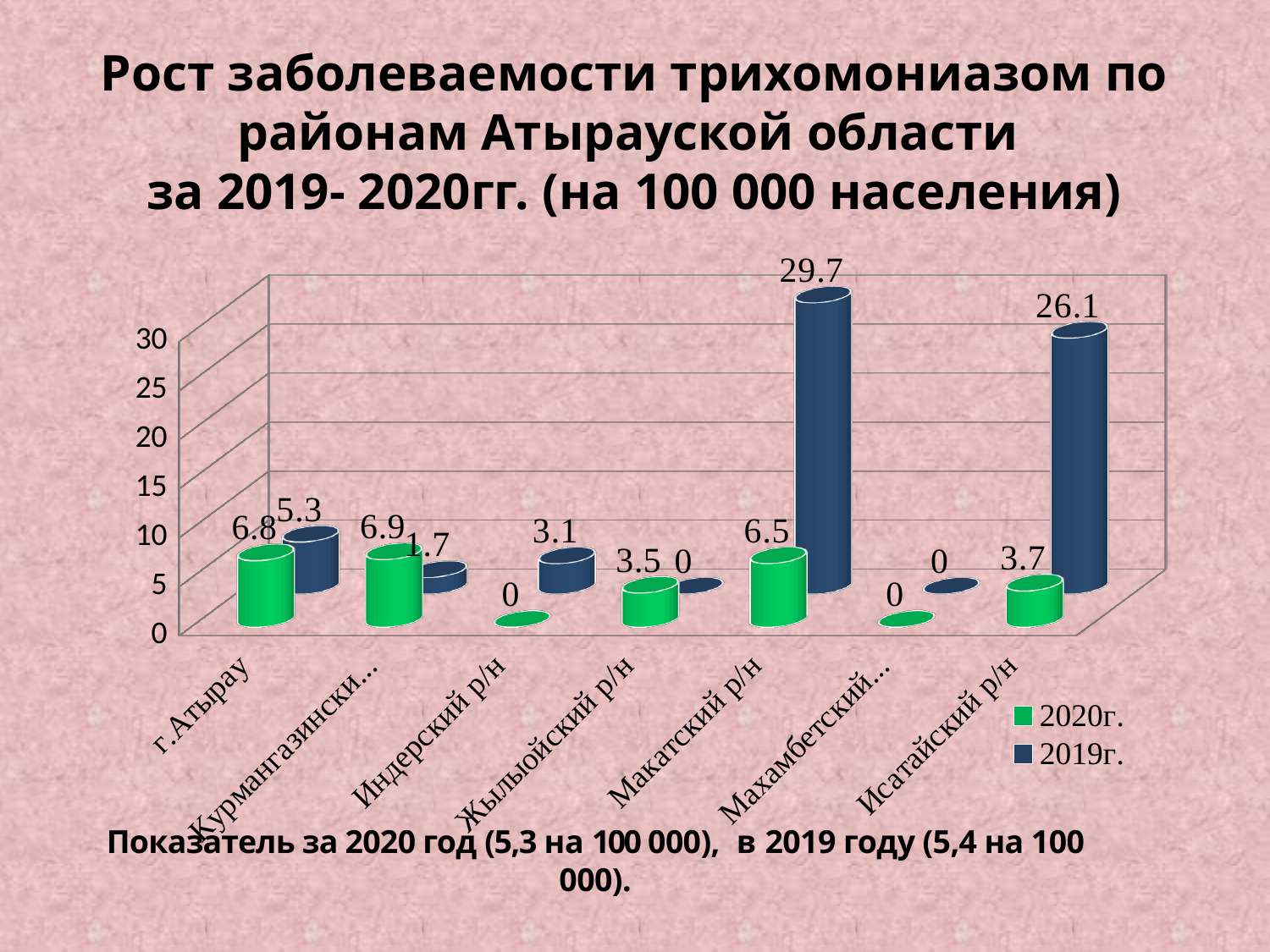
What is the 2019г. value for Индерский р/н? 3.1 What is the 2019г. value for Исатайский р/н? 26.1 What is the 2019г. value for Макатский р/н? 29.7 What is the difference between the 2019г. and 2020г. values for Макатский р/н? 23.2 What is the difference between the 2019г. and 2020г. values for Исатайский р/н? 22.4 What is the 2020г. value for Жылыойский р/н? 3.5 How many series does the legend list? 2 Which district has the highest 2019г. value? Макатский р/н For г.Атырау, which series has the larger value, 2020г. or 2019г.? 2020г. How many districts (categories) are shown on the x axis? 7 What kind of chart is shown on the slide? bar chart What is the 2020г. value for г.Атырау? 6.8